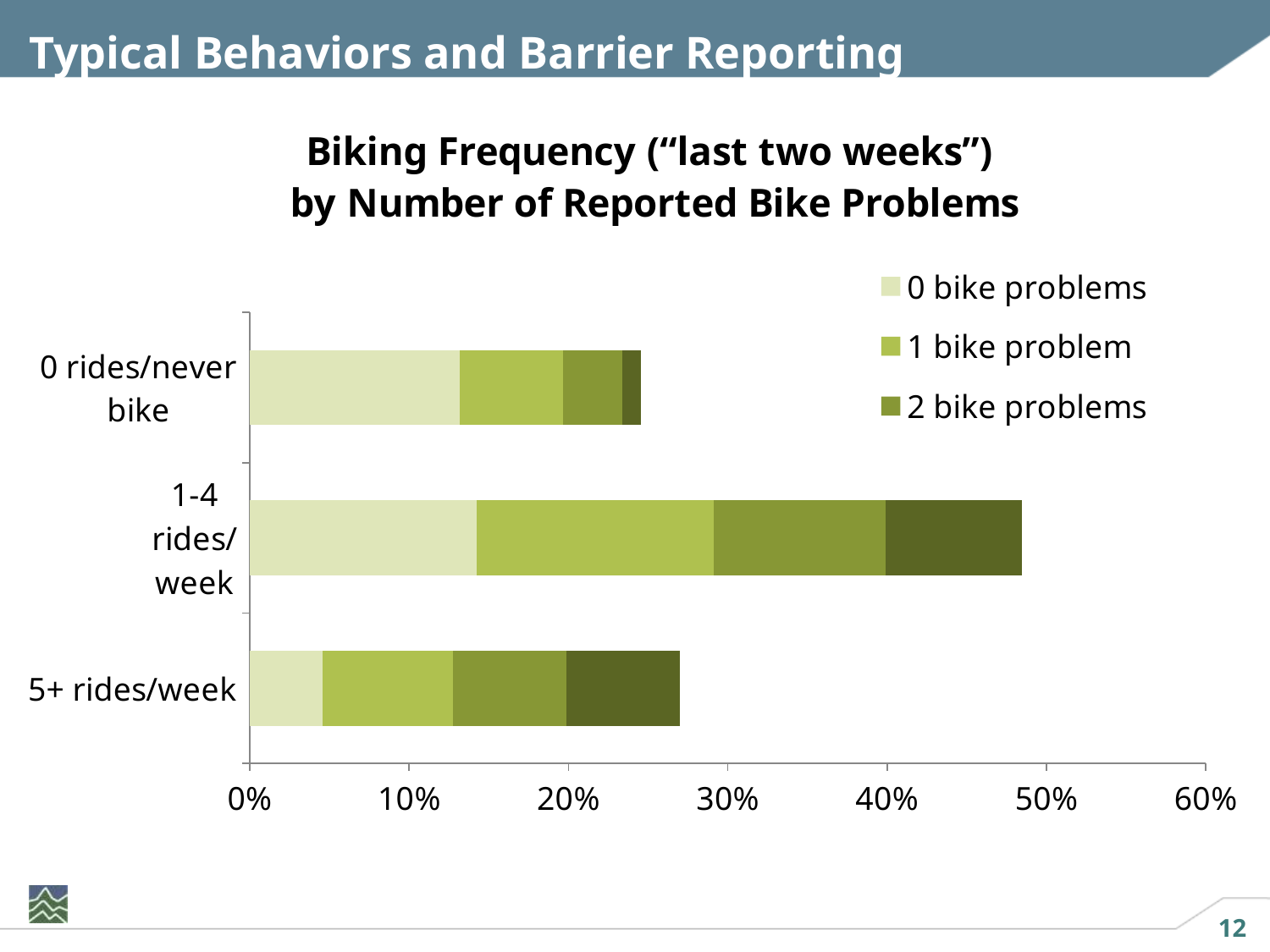
Is the total bar for 5+ rides/week greater or less than 20%? greater Which legend entry is shown in the lightest green colour? 0 bike problems Which biking frequency category has the longest total bar? 1-4 rides/week How many biking frequency categories are shown on the chart? 3 Is the total bar for 1-4 rides/week greater or less than 40%? greater What is the title of the chart? Biking Frequency ("last two weeks") by Number of Reported Bike Problems Is the total bar for 0 rides/never bike greater or less than 30%? less How many series does the legend list? 3 Which is larger, the 0 bike problems segment for 1-4 rides/week or for 5+ rides/week? 1-4 rides/week What kind of chart is shown on the slide? Stacked bar chart